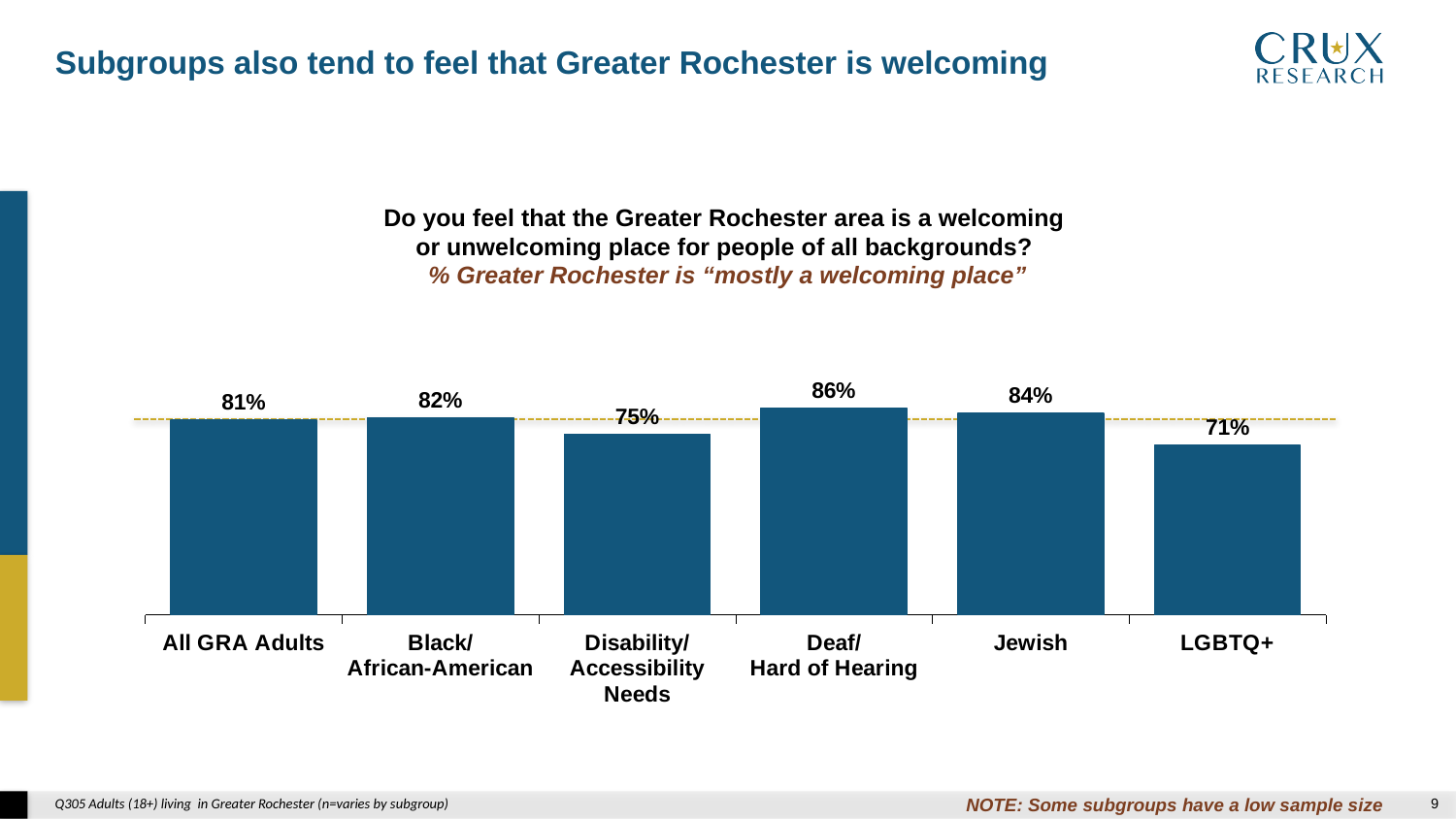
What percentage of All GRA Adults say Greater Rochester is mostly a welcoming place? 81% What kind of chart is shown on the slide? Bar chart What is the value shown for the LGBTQ+ subgroup? 71% Which subgroup has the highest percentage saying Greater Rochester is mostly a welcoming place? Deaf/Hard of Hearing Which subgroup has the lowest percentage saying Greater Rochester is mostly a welcoming place? LGBTQ+ How many categories are shown in the chart? 6 What is the difference in percentage points between the Jewish subgroup and All GRA Adults? 3 What is the value shown for the Black/African-American subgroup? 82% Which is larger, the value for Jewish or the value for Disability/Accessibility Needs? Jewish What is the value shown for the Disability/Accessibility Needs subgroup? 75% What is the italic subtitle line of the chart? % Greater Rochester is "mostly a welcoming place" What is the difference in percentage points between the Deaf/Hard of Hearing and LGBTQ+ subgroups? 15